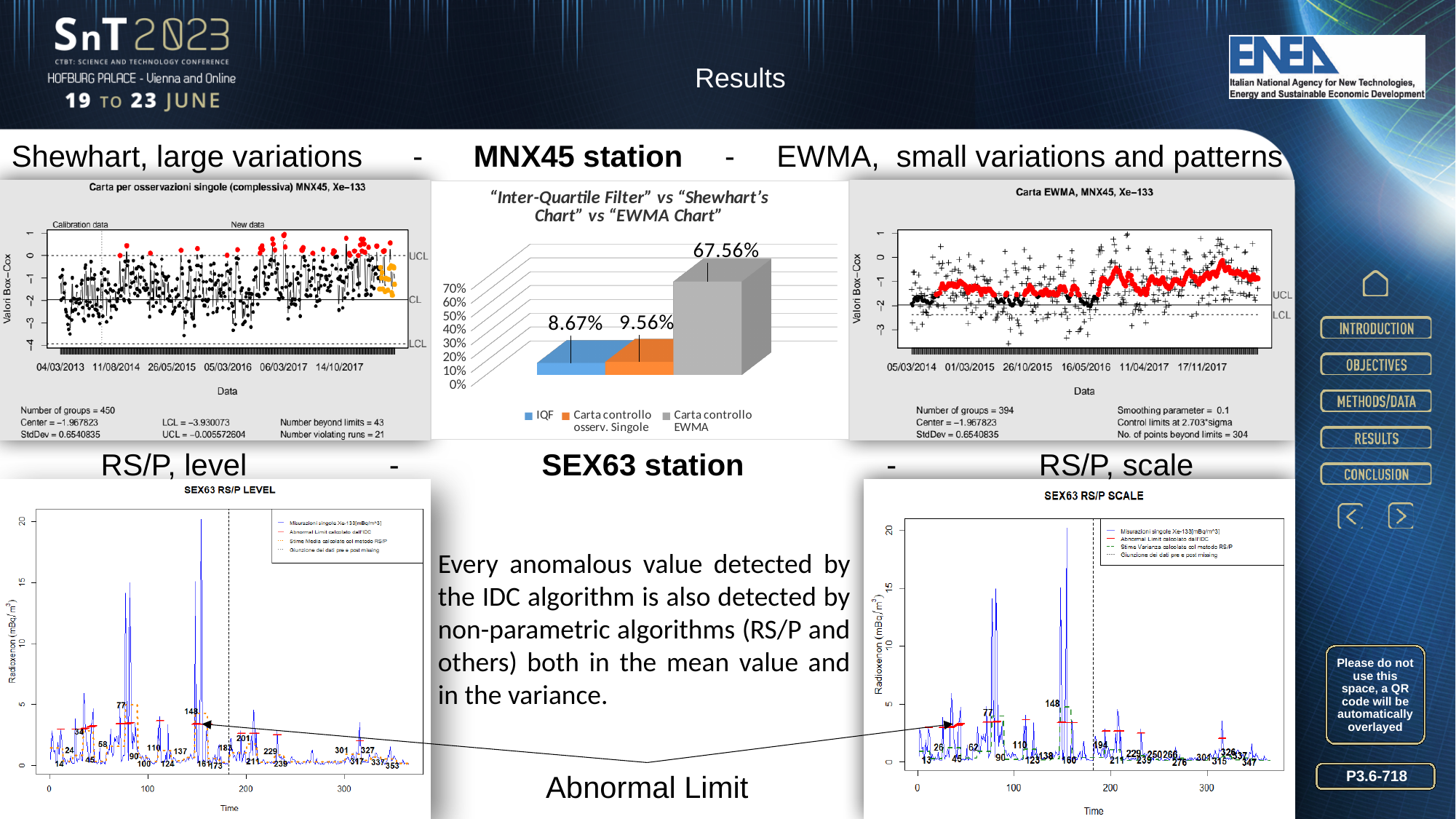
In the "Inter-Quartile Filter" vs "Shewhart's Chart" vs "EWMA Chart" bar chart, which is larger: the value for IQF or the value for Carta controllo EWMA? Carta controllo EWMA In the "Inter-Quartile Filter" vs "Shewhart's Chart" vs "EWMA Chart" bar chart, what is the value for IQF? 8.67% In the "Inter-Quartile Filter" vs "Shewhart's Chart" vs "EWMA Chart" bar chart, is the value for Carta controllo EWMA greater or less than 60%? greater In the "Inter-Quartile Filter" vs "Shewhart's Chart" vs "EWMA Chart" bar chart, what is the value for Carta controllo osserv. Singole? 9.56% In the "Inter-Quartile Filter" vs "Shewhart's Chart" vs "EWMA Chart" bar chart, which series has the highest value? Carta controllo EWMA In the "Inter-Quartile Filter" vs "Shewhart's Chart" vs "EWMA Chart" bar chart, what colour is the Carta controllo EWMA bar? grey What kind of chart is the "Inter-Quartile Filter" vs "Shewhart's Chart" vs "EWMA Chart" chart in the centre of the slide? bar chart In the "Inter-Quartile Filter" vs "Shewhart's Chart" vs "EWMA Chart" bar chart, what is the value for Carta controllo EWMA? 67.56% In the "Inter-Quartile Filter" vs "Shewhart's Chart" vs "EWMA Chart" bar chart, what is the difference between the Carta controllo osserv. Singole value and the IQF value? 0.89% How many series does the legend of the "Inter-Quartile Filter" vs "Shewhart's Chart" vs "EWMA Chart" chart list? 3 In the "Inter-Quartile Filter" vs "Shewhart's Chart" vs "EWMA Chart" bar chart, what is the difference between the Carta controllo EWMA value and the IQF value? 58.89% In the "Inter-Quartile Filter" vs "Shewhart's Chart" vs "EWMA Chart" bar chart, which series has the lowest value? IQF